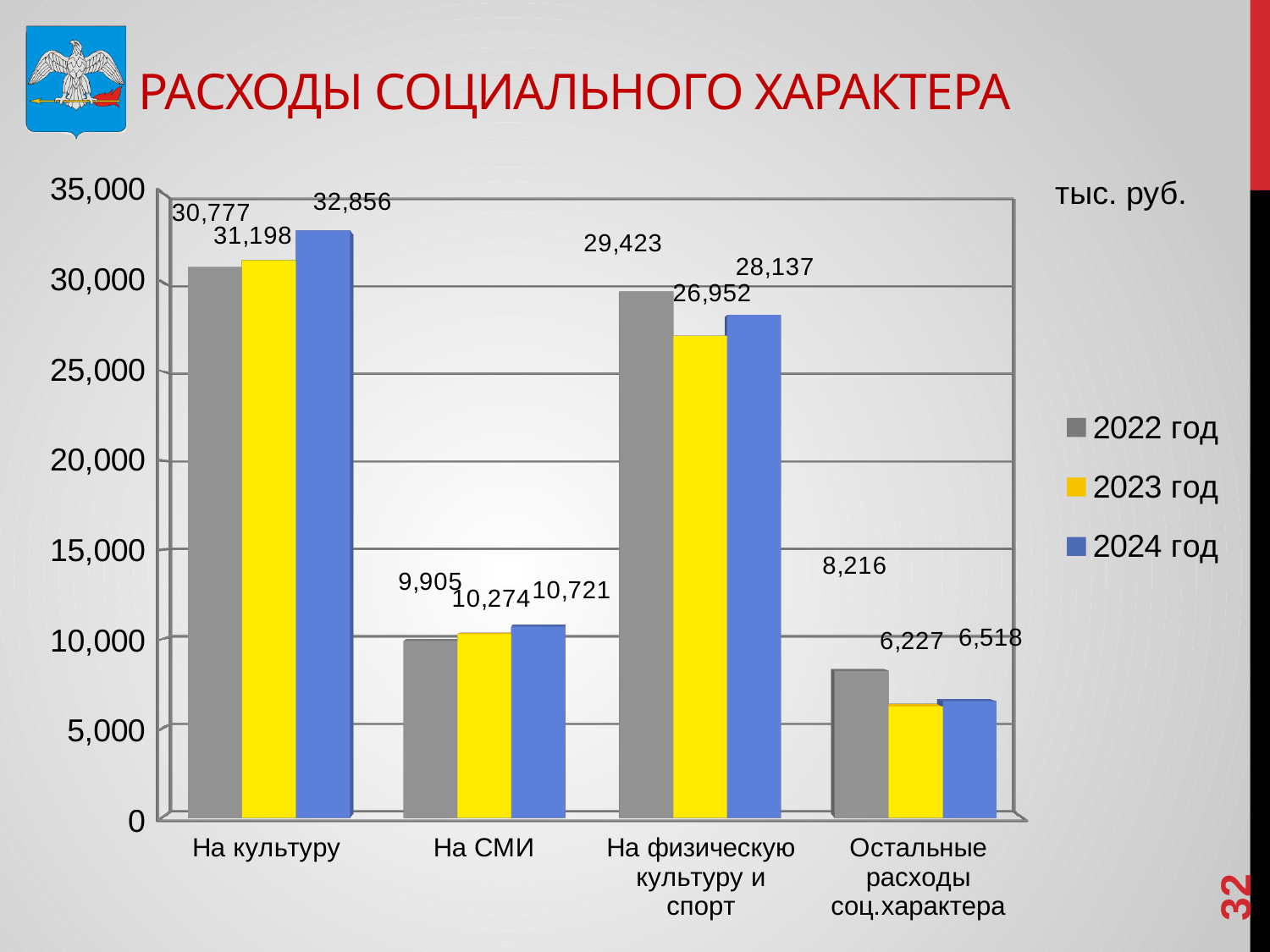
How many categories are shown on the x axis? 4 Is the 2023 год value for "На СМИ" greater or less than 10,000? greater Which category has the lowest value in the 2023 год series? Остальные расходы соц.характера Which is larger for "На физическую культуру и спорт": the 2022 год value or the 2024 год value? 2022 год How many series does the legend list? 3 What is the value for "Остальные расходы соц.характера" in the 2022 год series? 8,216 What is the difference between the 2024 год and 2022 год values for "На культуру"? 2,079 What is the value for "На физическую культуру и спорт" in the 2023 год series? 26,952 Which category has the highest value in the 2024 год series? На культуру What is the value for "На СМИ" in the 2022 год series? 9,905 What is the value for "На культуру" in the 2024 год series? 32,856 What kind of chart is shown on the slide? bar chart